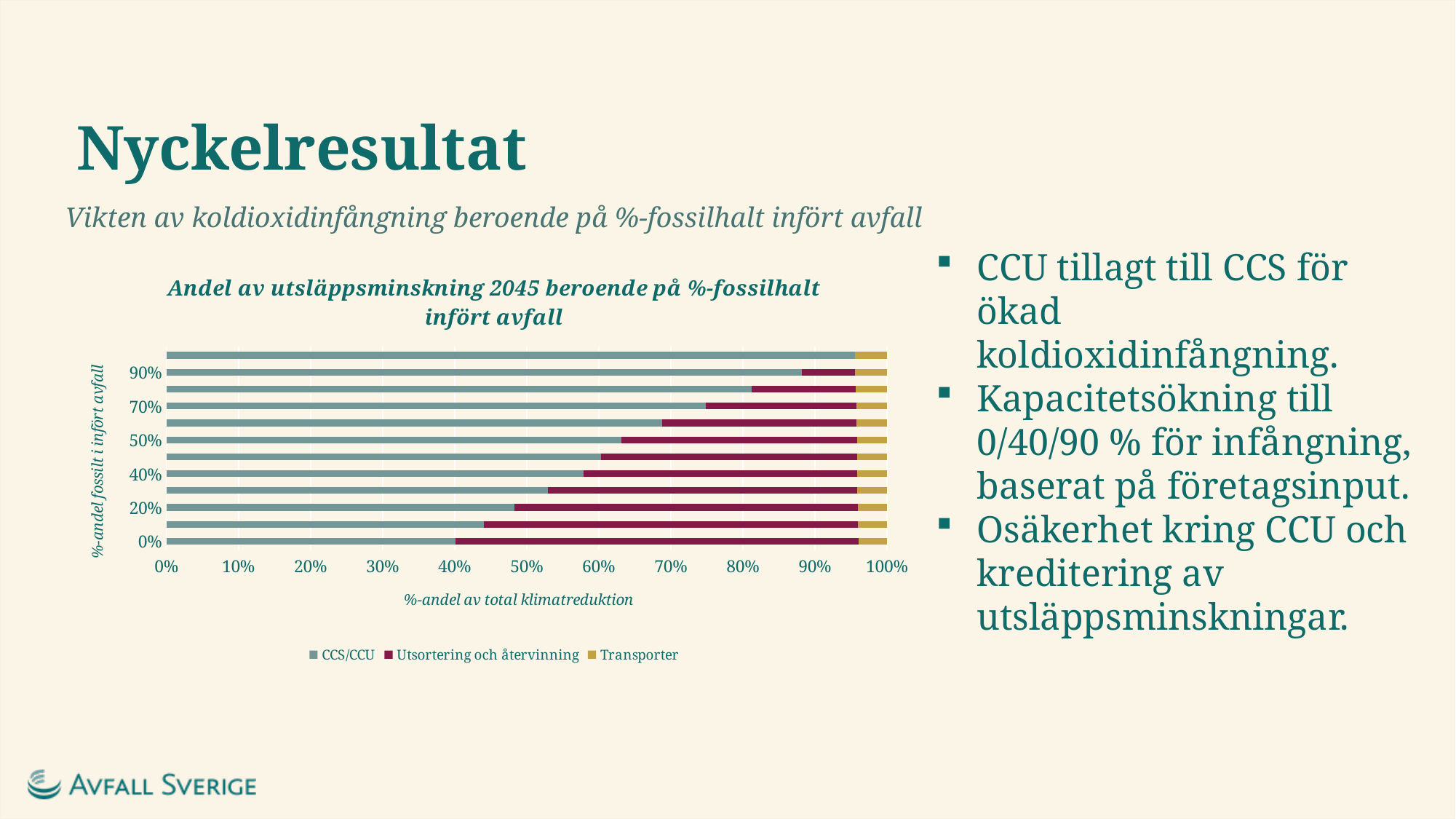
What kind of chart is shown on the slide? Stacked bar chart For the 0% fossil share bar, is the CCS/CCU share greater or less than 30%? greater Which bar has the larger CCS/CCU share: the 0% fossil share bar or the 90% fossil share bar? 90% For the 90% fossil share bar, is the CCS/CCU share greater or less than 80%? greater For the 0% fossil share bar, is the Utsortering och återvinning share greater or less than 50%? greater As the fossil share of incoming waste increases, does the CCS/CCU share of the total climate reduction increase or decrease? increase In the 0% fossil share bar, which segment is larger: CCS/CCU or Utsortering och återvinning? Utsortering och återvinning What is the title of the chart? Andel av utsläppsminskning 2045 beroende på %-fossilhalt infört avfall How many series does the chart legend list? 3 What are the three series named in the chart legend? CCS/CCU, Utsortering och återvinning, Transporter